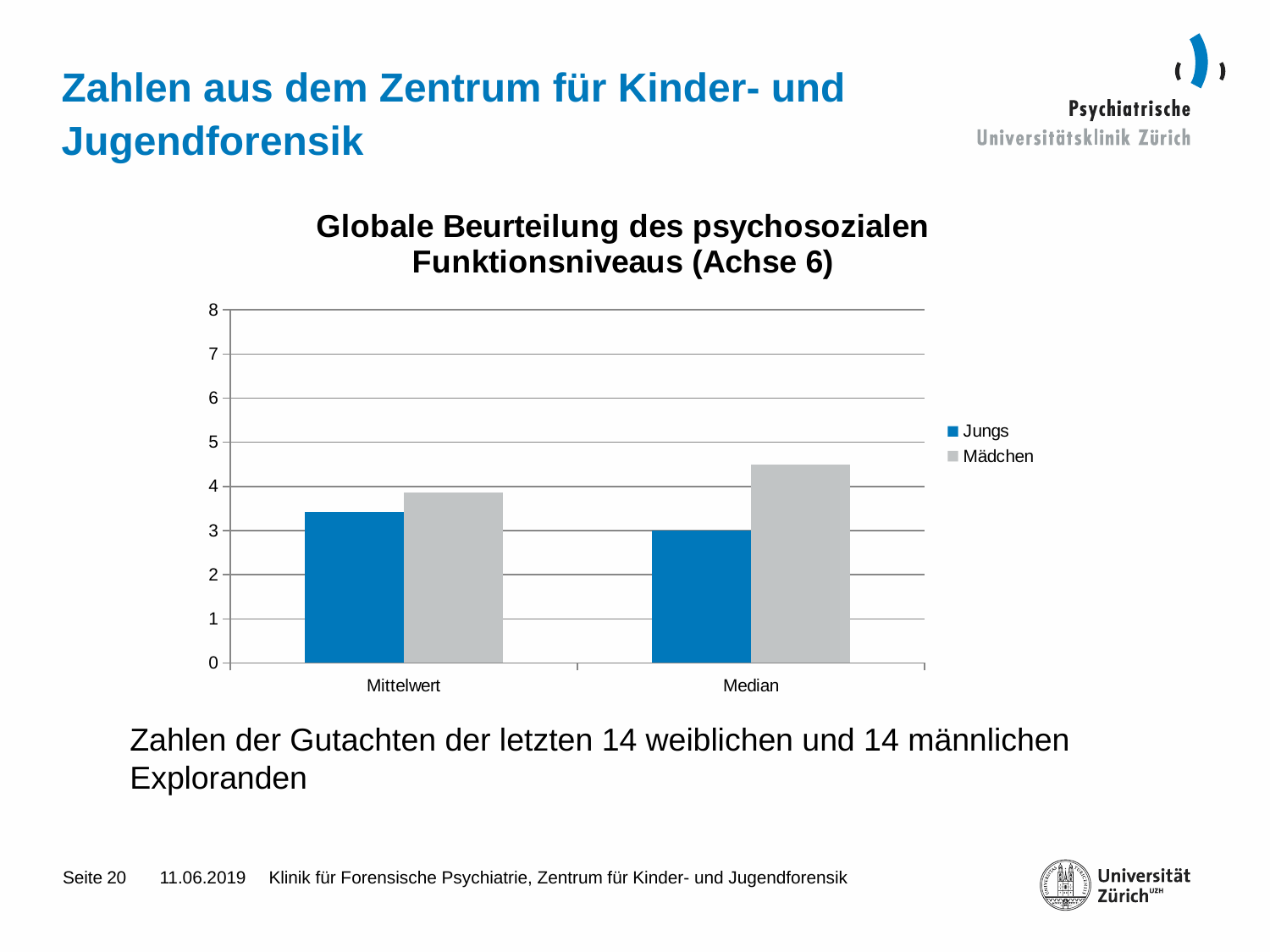
For Mittelwert, which series has the larger value, Jungs or Mädchen? Mädchen Is the Mittelwert value for Mädchen greater or less than 4? less Is the Mittelwert value for Jungs greater or less than 3? greater What is the Median value for Jungs? 3 Is the Median value for Mädchen greater or less than 4? greater Which bar is the lowest in the chart? Jungs, Median Which series is shown in dark blue? Jungs Which bar is the highest in the chart? Mädchen, Median How many categories are shown on the x axis? 2 What is the title of the chart? Globale Beurteilung des psychosozialen Funktionsniveaus (Achse 6) What kind of chart is shown on the slide? bar chart How many series does the legend list? 2